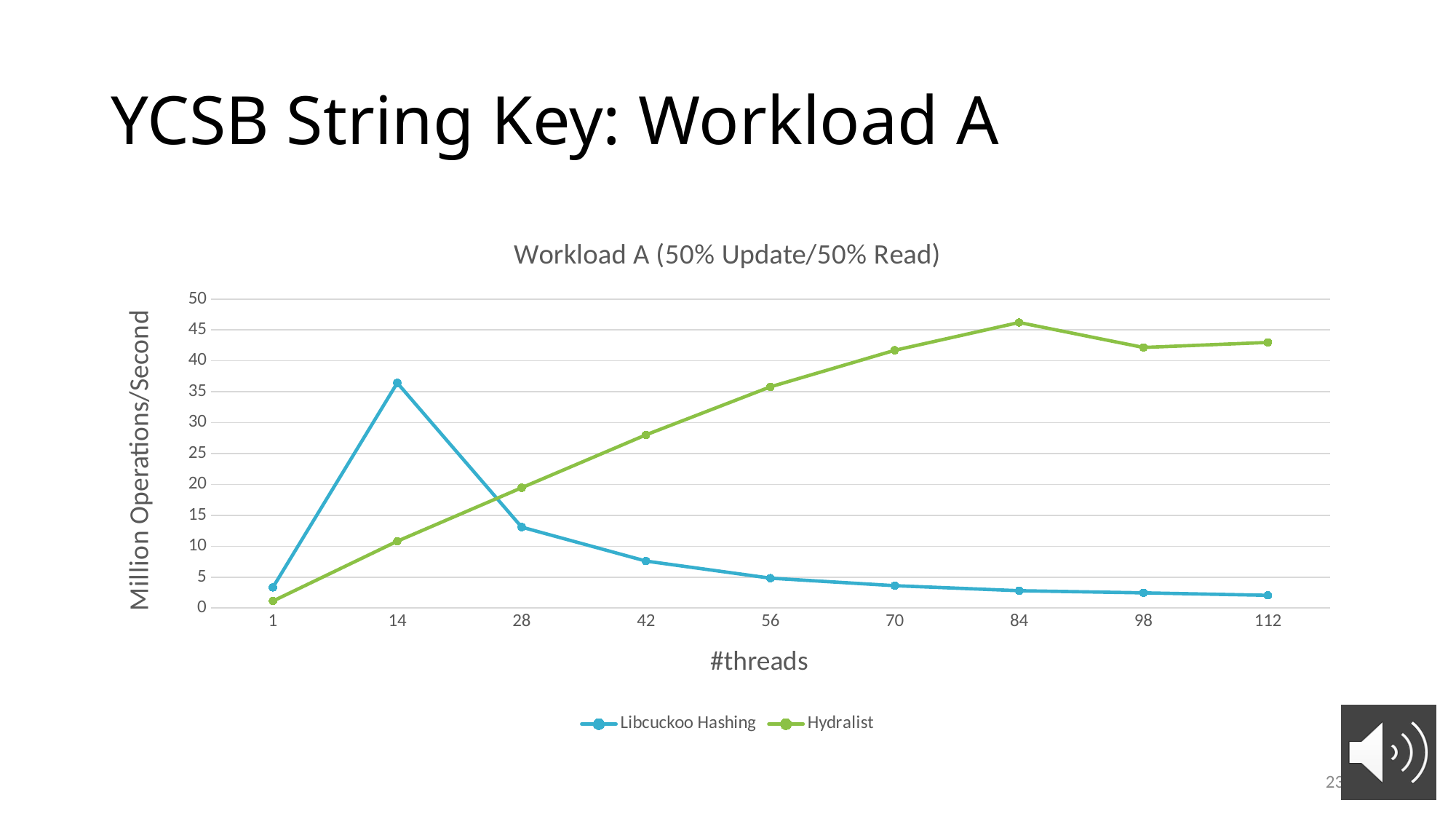
At which number of threads does Hydralist reach its highest value? 84 Is the value for Libcuckoo Hashing at 56 threads greater or less than 10? less At which number of threads is Hydralist at its lowest value? 1 At 112 threads, which series has the higher value, Libcuckoo Hashing or Hydralist? Hydralist What kind of chart is shown on the slide? line chart How many thread counts are plotted along the x axis? 9 Is the value for Hydralist at 84 threads greater or less than 40? greater At 14 threads, which series has the higher value, Libcuckoo Hashing or Hydralist? Libcuckoo Hashing Does the Libcuckoo Hashing line rise or fall from 14 threads to 112 threads? fall How many series does the legend list? 2 What is the label of the y axis? Million Operations/Second At which number of threads does Libcuckoo Hashing reach its highest value? 14